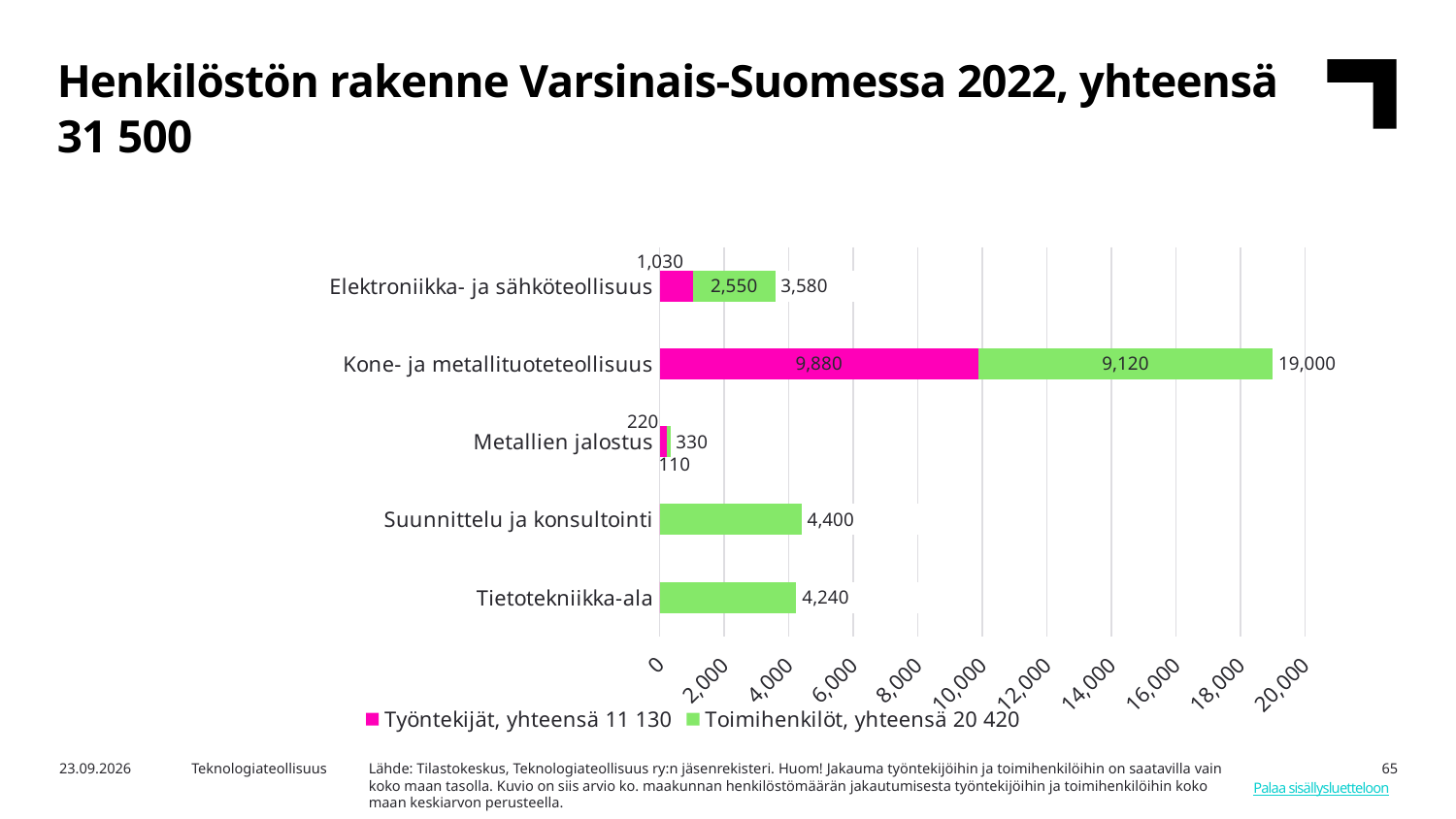
What is the Toimihenkilöt value for Elektroniikka- ja sähköteollisuus? 2,550 What is the Työntekijät value for Kone- ja metallituoteteollisuus? 9,880 What type of chart is shown on the slide? Stacked bar chart What total is given for Toimihenkilöt in the legend? 20 420 Which category has the lowest total? Metallien jalostus Which category has the highest total? Kone- ja metallituoteteollisuus How many categories are shown on the chart? 5 Which is larger, the Työntekijät value or the Toimihenkilöt value for Kone- ja metallituoteteollisuus? Työntekijät What is the difference between the totals of Suunnittelu ja konsultointi and Tietotekniikka-ala? 160 What is the total for Kone- ja metallituoteteollisuus? 19,000 What is the total for Metallien jalostus? 330 How many series does the legend list? 2